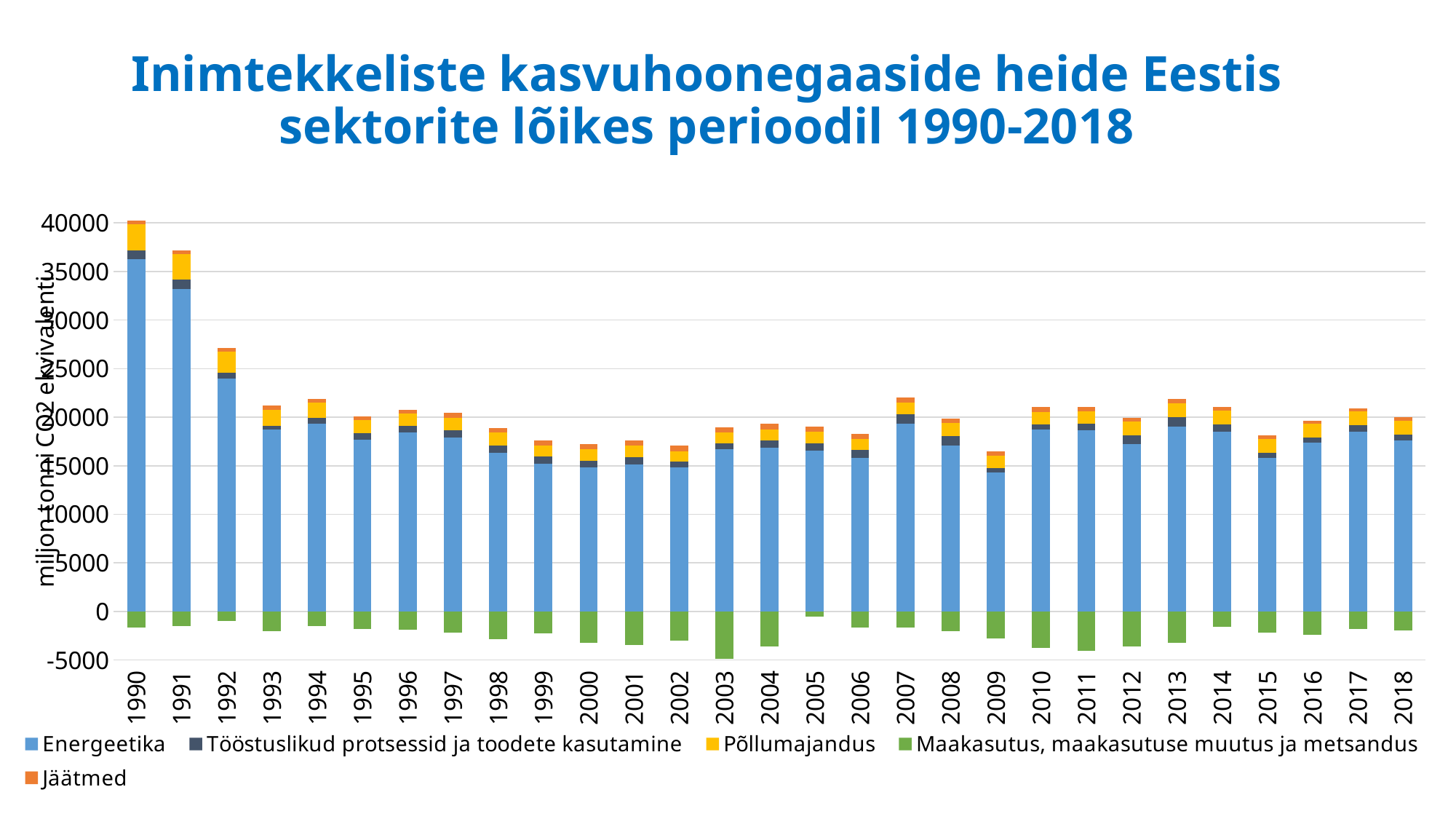
Is the Energeetika value for 1990 greater or less than 35000? greater Is the Energeetika value for 1991 greater or less than 30000? greater In which year does the Maakasutus, maakasutuse muutus ja metsandus series reach its most negative value? 2003 How many years are plotted along the x axis? 29 In which year is the Energeetika value highest? 1990 How many series does the legend list? 5 Which year has the larger Energeetika value, 2007 or 2009? 2007 What is the title of the chart? Inimtekkeliste kasvuhoonegaaside heide Eestis sektorite lõikes perioodil 1990-2018 In which year is the Maakasutus, maakasutuse muutus ja metsandus value closest to zero? 2005 What kind of chart is shown on the slide? Stacked bar chart Does the Energeetika value rise or fall from 1990 to 1993? Fall Which series is shown in yellow in the legend? Põllumajandus